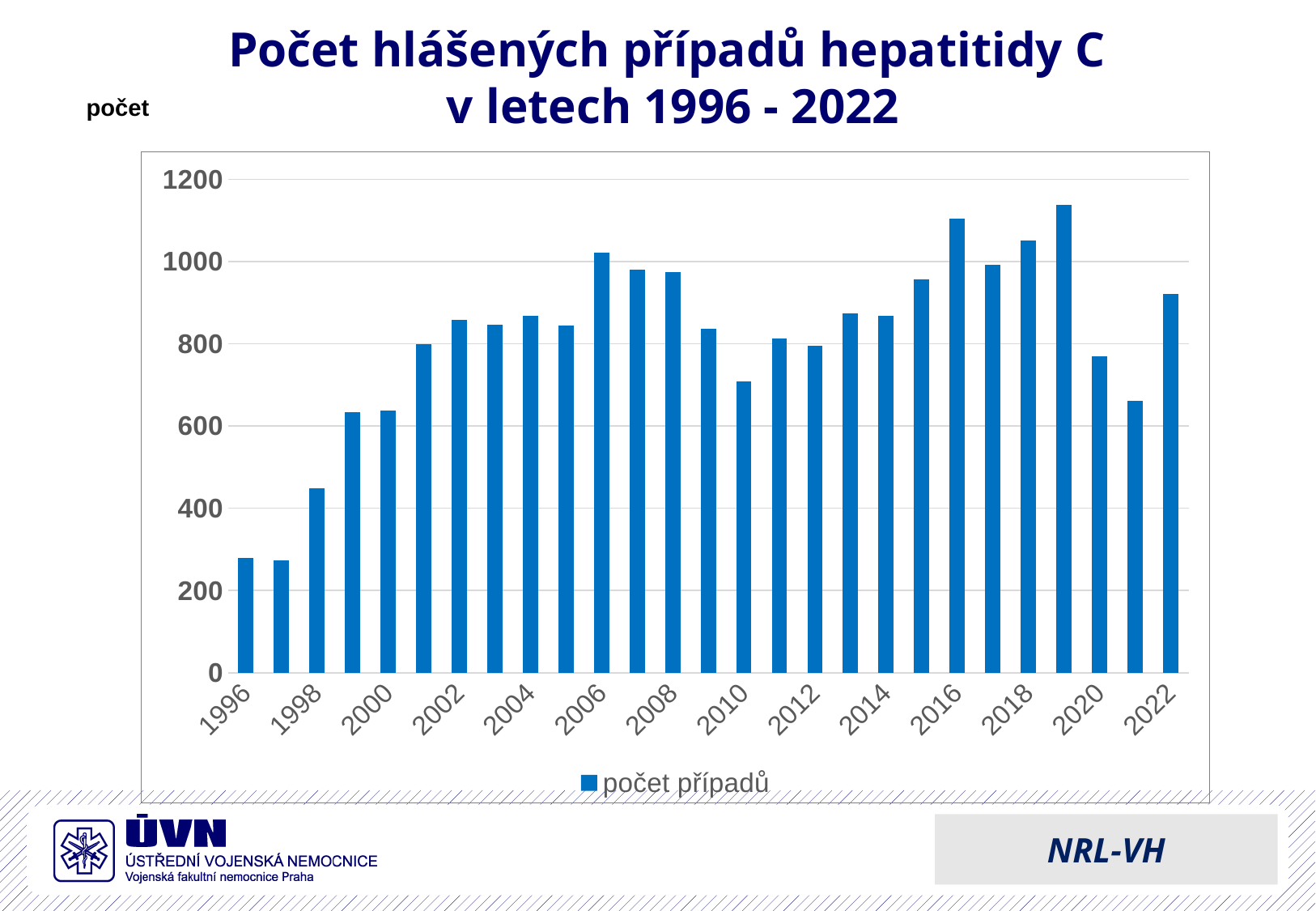
Is the value for 2020 greater or less than 800? less Which year has the larger value, 1998 or 2000? 2000 How many series does the legend list? 1 How many years (bars) are plotted in the chart? 27 Do the values generally rise or fall from 1996 to 2006? rise Which year has the highest number of reported hepatitis C cases? 2019 Is the value for 2006 greater or less than 1000? greater Which year has the larger value, 2006 or 2010? 2006 What kind of chart is shown on the slide? bar chart Is the value for 1996 greater or less than 400? less What is the legend entry for the plotted series? počet případů